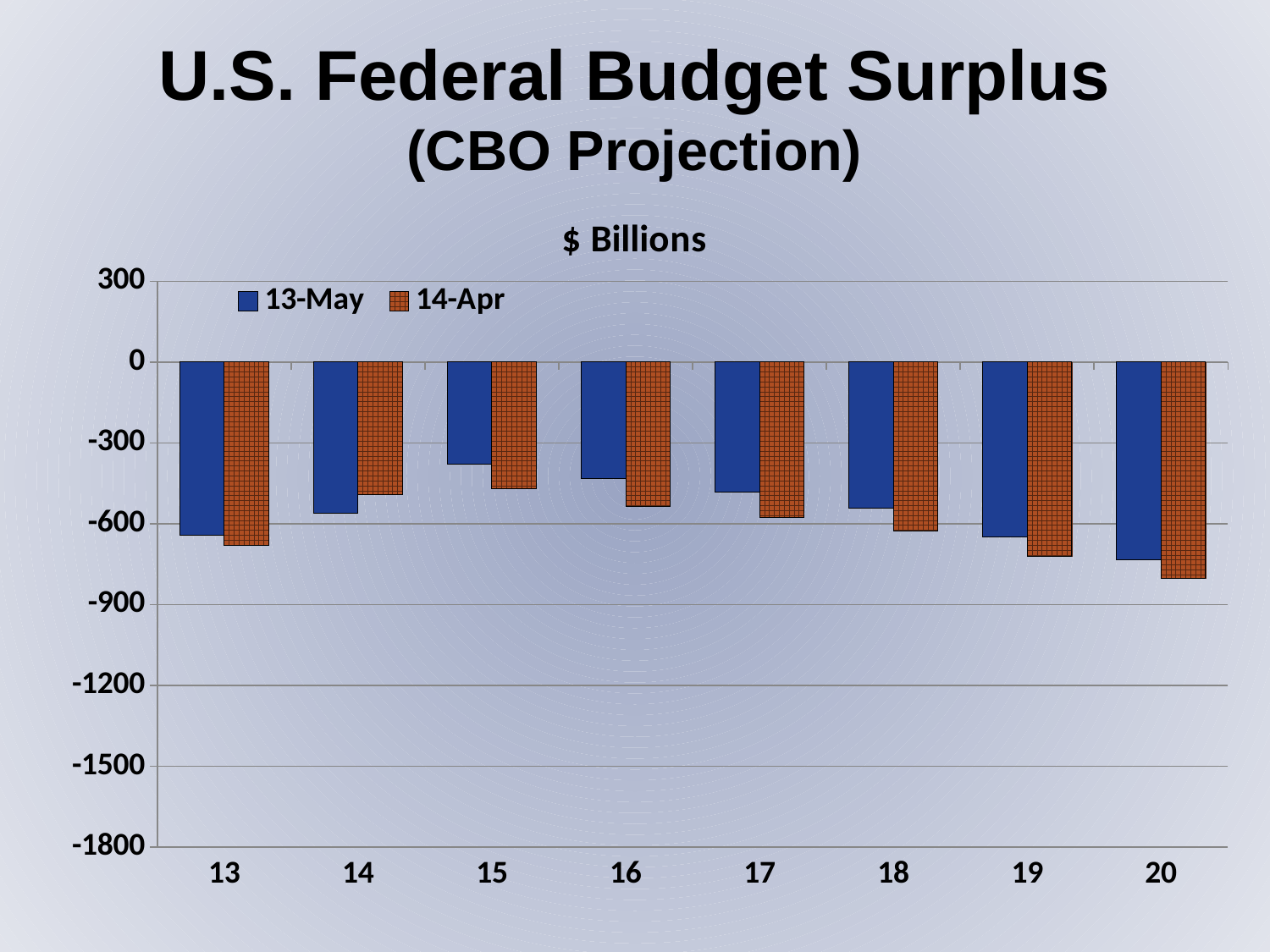
How many years are shown along the x axis? 8 Is the 14-Apr value for year 20 greater or less than -600? less Is the 13-May value for year 15 greater or less than -300? less For which year is the 14-Apr value lowest? 20 Do the 13-May values rise or fall from year 15 to year 20? fall Is the 14-Apr value for year 14 greater or less than -600? greater What are the two series named in the legend? 13-May and 14-Apr What unit label is shown above the chart? $ Billions For year 15, which series has the larger value, 13-May or 14-Apr? 13-May For which year is the 13-May value highest (closest to zero)? 15 What kind of chart is shown on the slide? bar chart How many series does the legend list? 2